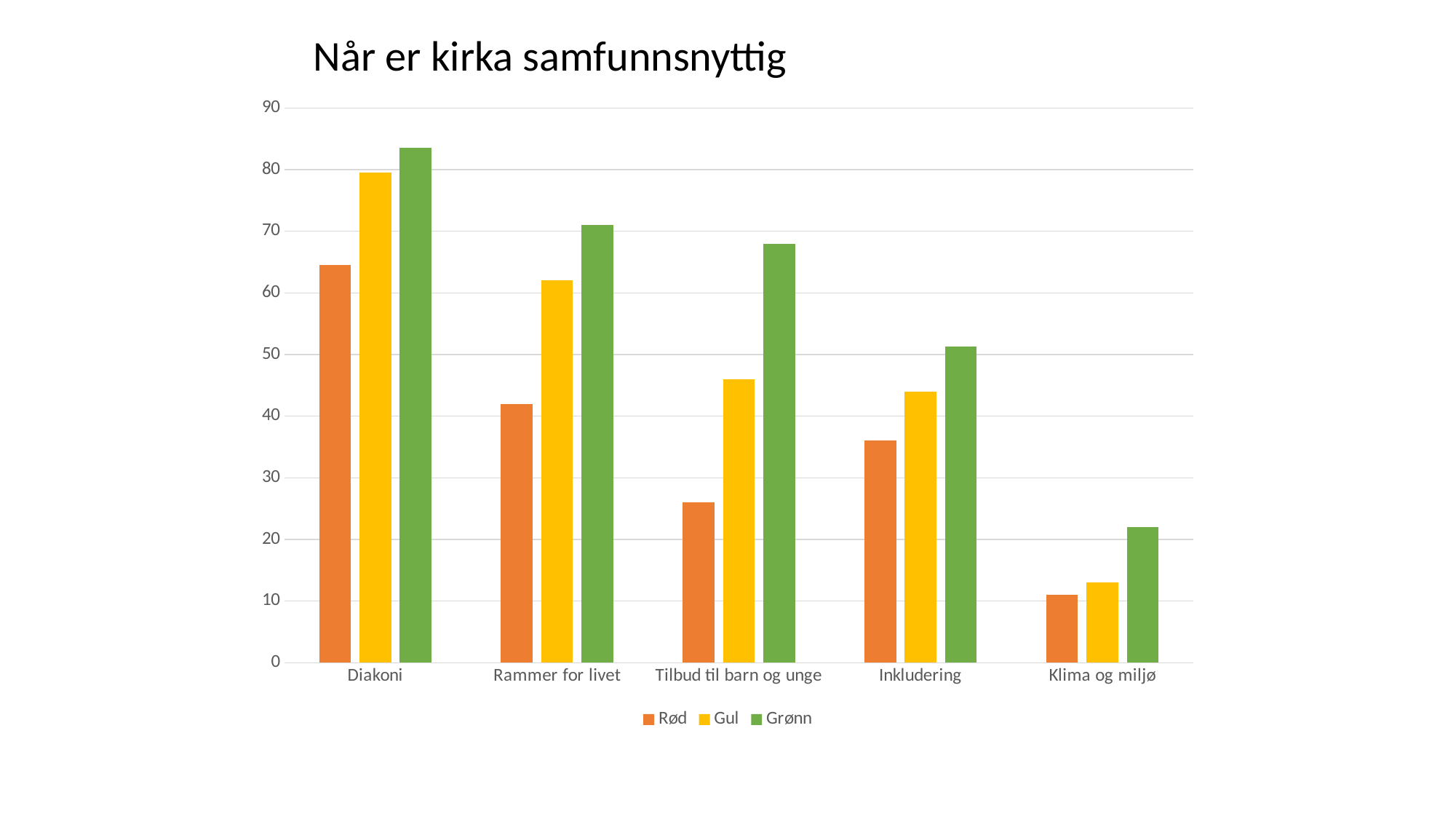
Do the values for the Grønn series rise or fall from left to right along the x axis? fall What kind of chart is shown on the slide? bar chart Which category has the lowest value for the Rød series? Klima og miljø Is the value for Grønn in Diakoni greater or less than 80? greater How many series does the legend list? 3 Is the value for Rød in Tilbud til barn og unge greater or less than 30? less What is the title of the chart? Når er kirka samfunnsnyttig Is the value for Rød in Diakoni greater or less than 60? greater Which category has the highest value for the Grønn series? Diakoni Which is larger: the Gul value for Diakoni or the Gul value for Rammer for livet? Diakoni How many categories are shown on the x axis? 5